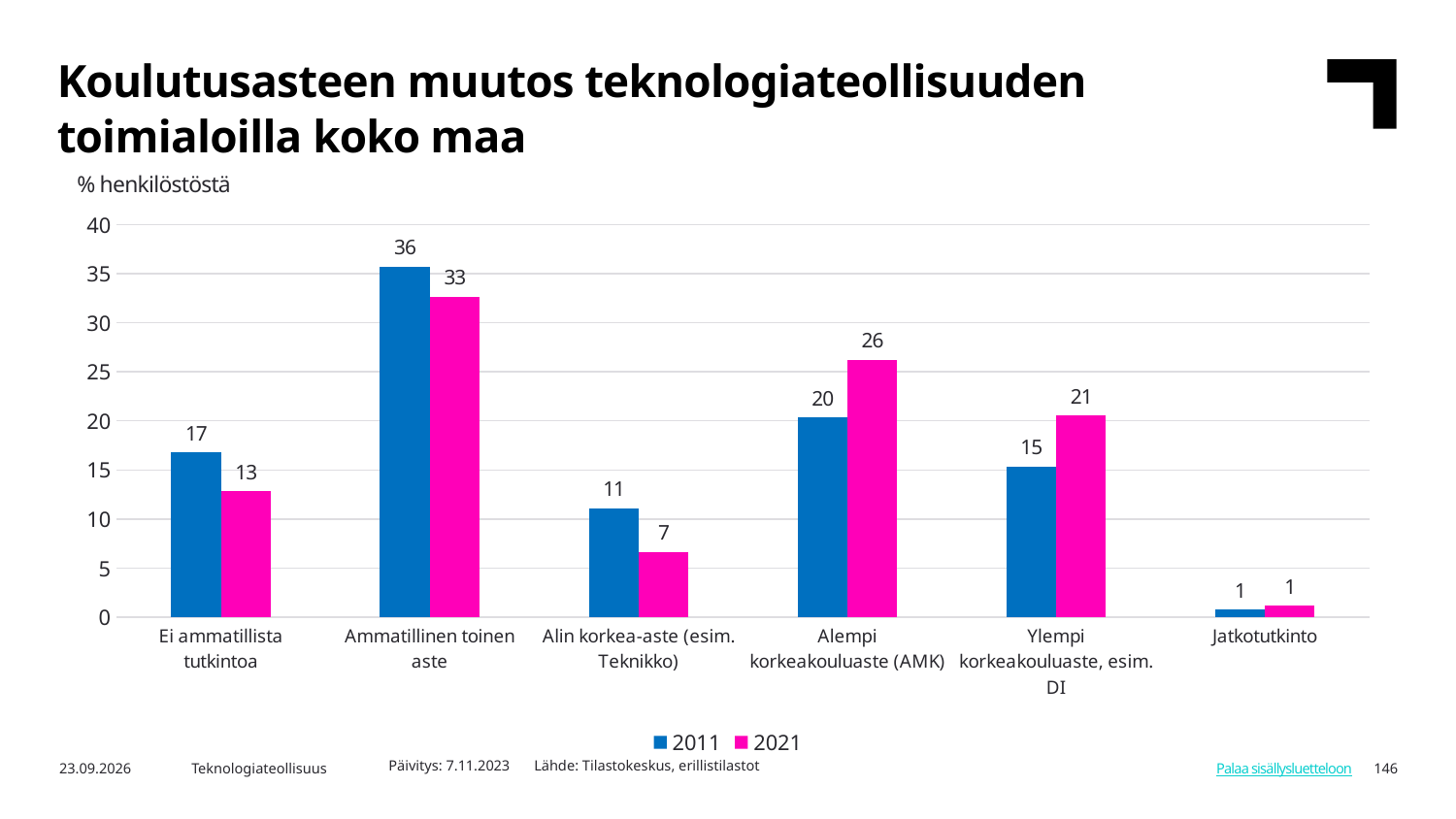
What is the difference between the 2021 and 2011 values for Alempi korkeakouluaste (AMK)? 6 Which category has the lowest 2011 value? Jatkotutkinto Which is larger for Ylempi korkeakouluaste, esim. DI: the 2011 value or the 2021 value? 2021 What is the 2021 value for Alin korkea-aste (esim. Teknikko)? 7 Which category has the highest 2021 value? Ammatillinen toinen aste How many series does the legend list? 2 What is the difference between the 2011 and 2021 values for Ei ammatillista tutkintoa? 4 What is the 2011 value for Ammatillinen toinen aste? 36 How many categories are shown on the x axis? 6 What unit is shown above the chart's y axis? % henkilöstöstä What is the 2021 value for Alempi korkeakouluaste (AMK)? 26 What kind of chart is shown on the slide? Bar chart